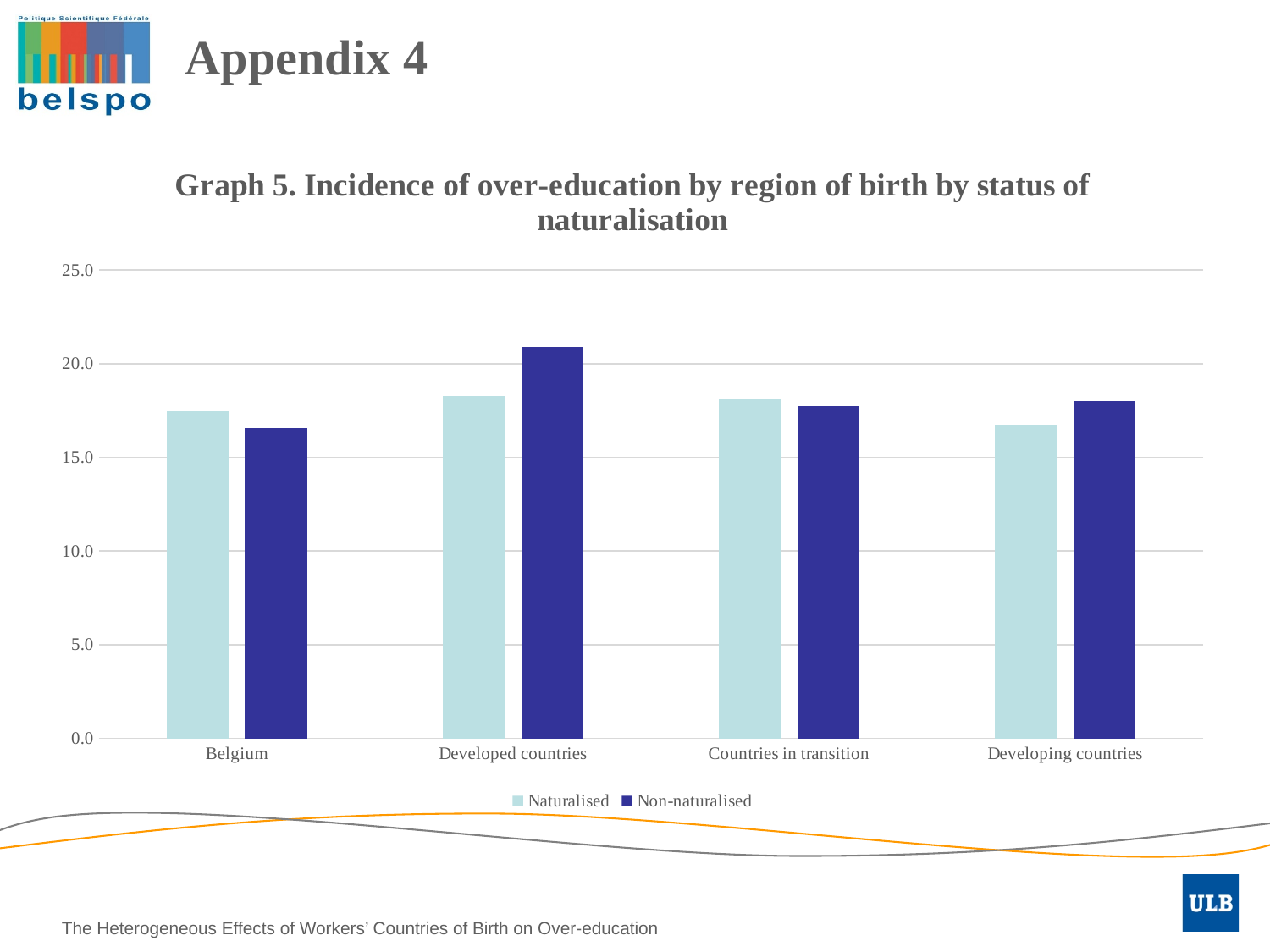
How many series does the legend list? 2 For Belgium, which is larger: the Naturalised or the Non-naturalised value? Naturalised Which region has the highest Non-naturalised value? Developed countries What is the title of the chart? Graph 5. Incidence of over-education by region of birth by status of naturalisation For Developed countries, which is larger: the Naturalised or the Non-naturalised value? Non-naturalised Which region has the lowest Non-naturalised value? Belgium Is the Naturalised value for Developing countries greater or less than 20.0? less What are the two series named in the legend? Naturalised and Non-naturalised How many regions of birth are shown on the x axis? 4 What kind of chart is shown on the slide? bar chart For Developing countries, which is larger: the Naturalised or the Non-naturalised value? Non-naturalised Is the Non-naturalised value for Developed countries greater or less than 20.0? greater